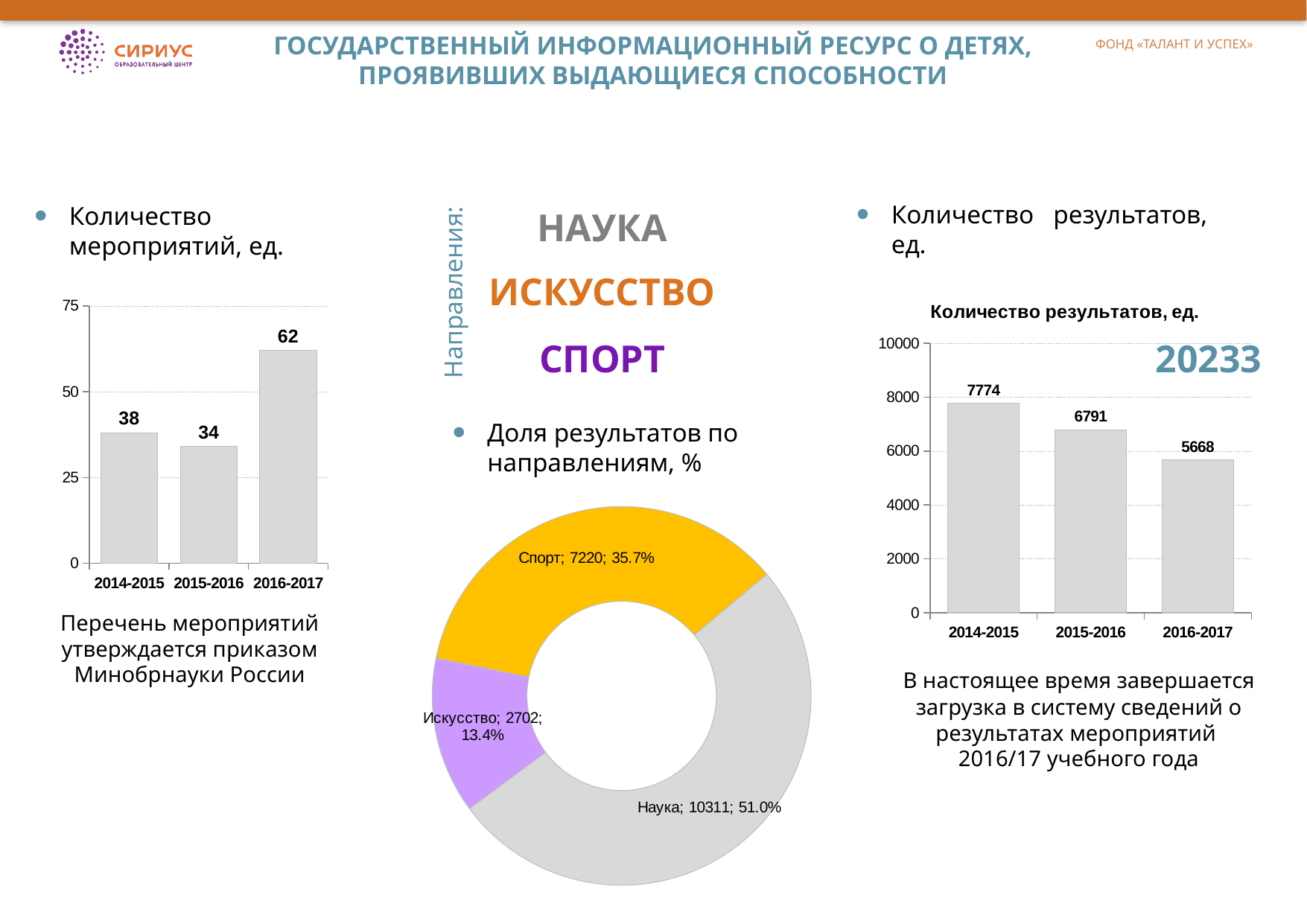
In the donut chart (Доля результатов по направлениям, %), what colour is the Спорт slice? Yellow In the donut chart (Доля результатов по направлениям, %), which direction has the smallest slice? Искусство In the left bar chart (Количество мероприятий, ед.), what is the value for 2016-2017? 62 What kind of chart is the right chart titled Количество результатов, ед.? Bar chart In the left bar chart (Количество мероприятий, ед.), which period has the lowest value? 2015-2016 In the right bar chart (Количество результатов, ед.), do the values rise or fall from 2014-2015 to 2016-2017? Fall In the right bar chart (Количество результатов, ед.), which period has the highest value? 2014-2015 In the left bar chart (Количество мероприятий, ед.), how many periods are shown on the x axis? 3 In the donut chart (Доля результатов по направлениям, %), what share does Наука have? 51.0% In the donut chart (Доля результатов по направлениям, %), what is the value for Искусство? 2702 In the right bar chart (Количество результатов, ед.), what is the value for 2015-2016? 6791 In the left bar chart (Количество мероприятий, ед.), what is the difference between the values for 2016-2017 and 2014-2015? 24